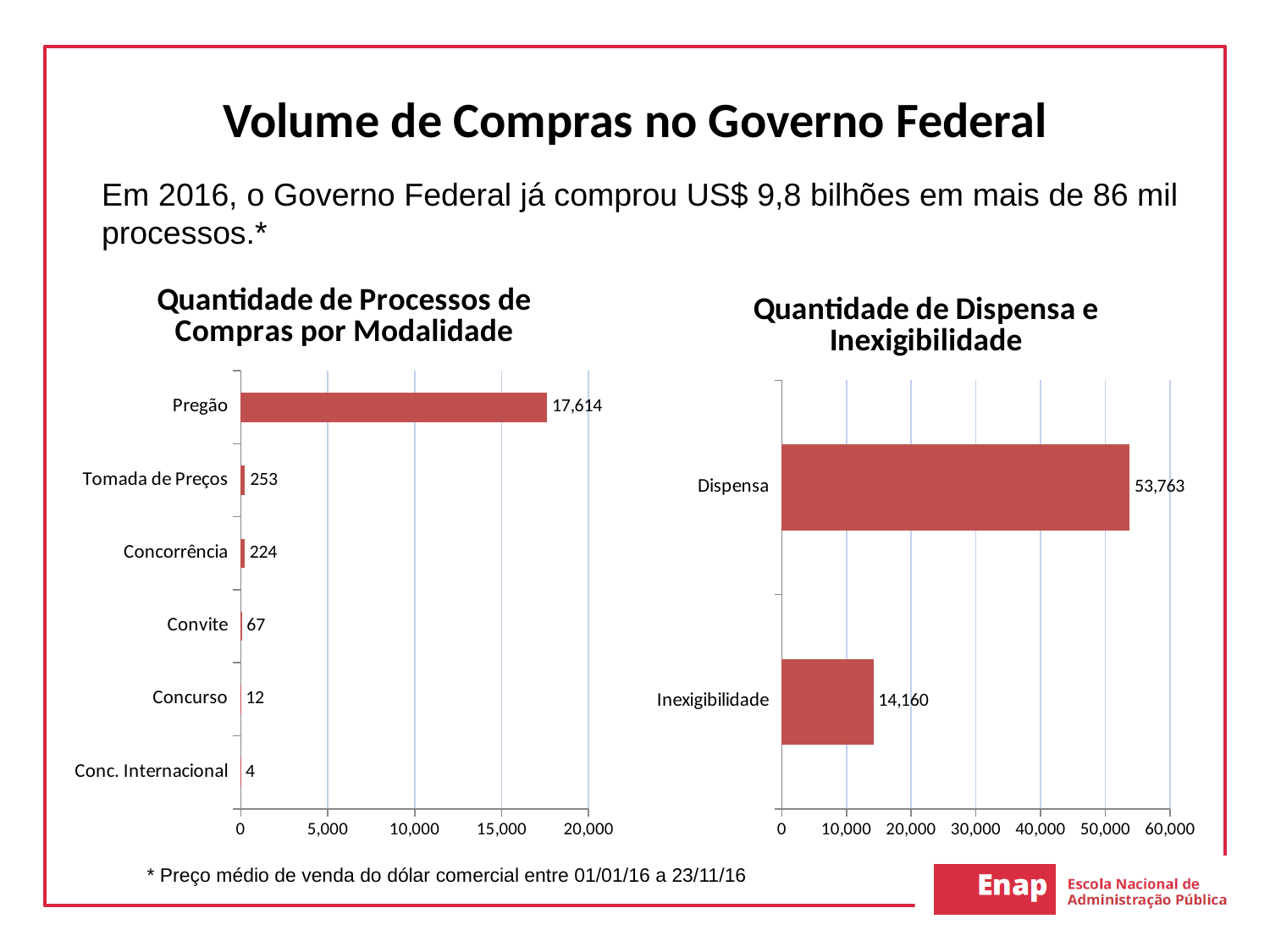
In the chart 'Quantidade de Dispensa e Inexigibilidade', what is the value for Dispensa? 53,763 In the chart 'Quantidade de Processos de Compras por Modalidade', what is the difference between Tomada de Preços and Concorrência? 29 In the chart 'Quantidade de Processos de Compras por Modalidade', what is the value for Concorrência? 224 In the chart 'Quantidade de Processos de Compras por Modalidade', which category has the highest value? Pregão In the chart 'Quantidade de Dispensa e Inexigibilidade', which is larger, Dispensa or Inexigibilidade? Dispensa In the chart 'Quantidade de Processos de Compras por Modalidade', which category has the lowest value? Conc. Internacional In the chart 'Quantidade de Processos de Compras por Modalidade', how many categories are shown? 6 In the chart 'Quantidade de Processos de Compras por Modalidade', is the value for Pregão greater or less than 15,000? greater In the chart 'Quantidade de Dispensa e Inexigibilidade', what is the difference between Dispensa and Inexigibilidade? 39,603 In the chart 'Quantidade de Processos de Compras por Modalidade', what is the value for Pregão? 17,614 In the chart 'Quantidade de Dispensa e Inexigibilidade', what is the value for Inexigibilidade? 14,160 What type of chart is 'Quantidade de Dispensa e Inexigibilidade'? Bar chart